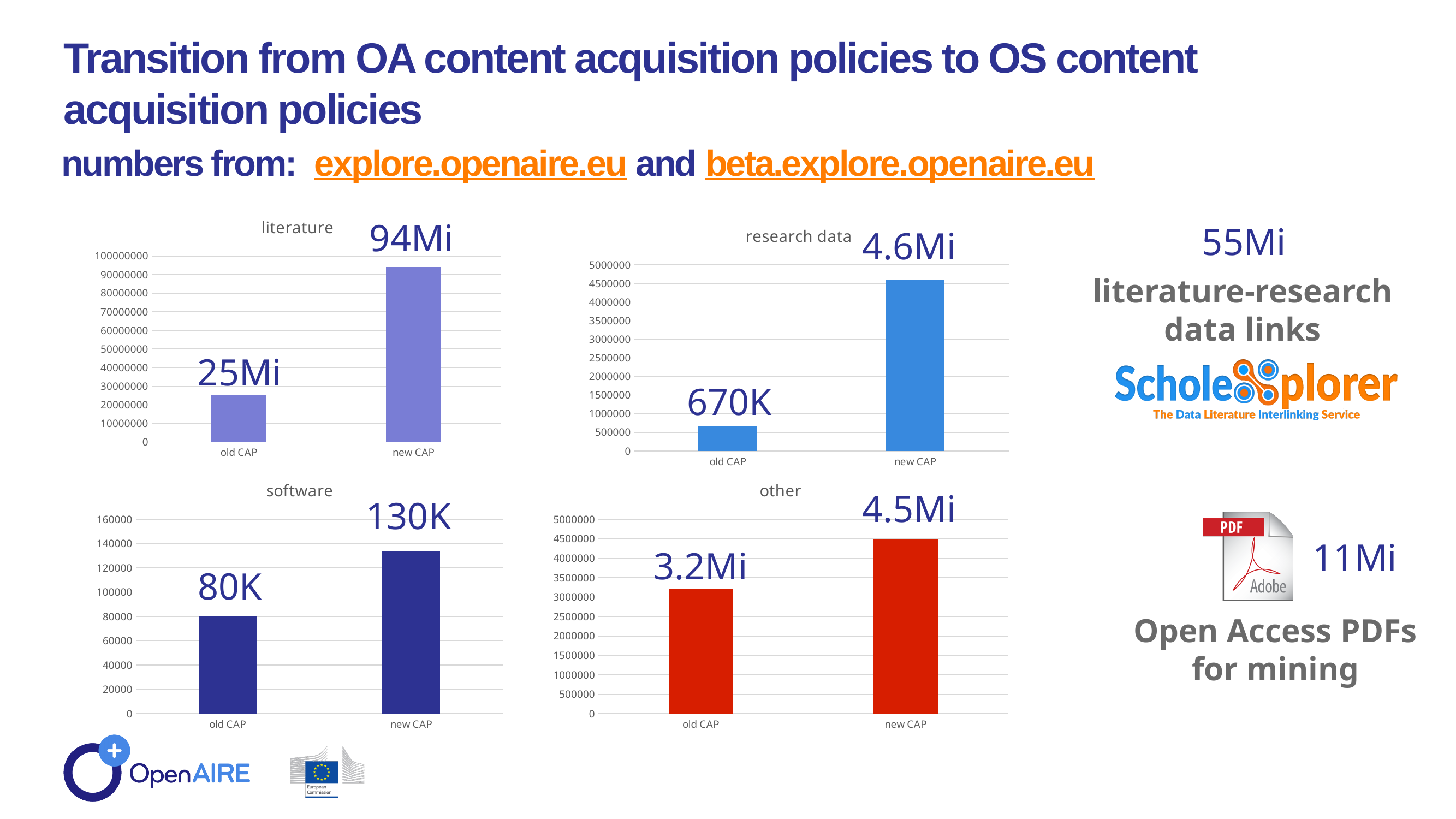
In the 'literature' chart, what is the value for old CAP? 25Mi In the 'research data' chart, what is the value for old CAP? 670K In the 'other' chart, what is the value for old CAP? 3.2Mi In the 'literature' chart, what is the difference between the new CAP and old CAP values? 69Mi In the 'software' chart, what is the difference between the new CAP and old CAP values? 50K In the 'other' chart, which category has the higher value, old CAP or new CAP? new CAP How many charts are shown on the slide? 4 In the 'software' chart, what is the value for new CAP? 130K What kind of chart is the 'software' chart? bar chart In the 'research data' chart, what is the value for new CAP? 4.6Mi In the 'research data' chart, is the value for old CAP greater or less than 1000000? less In the 'literature' chart, what is the value for new CAP? 94Mi